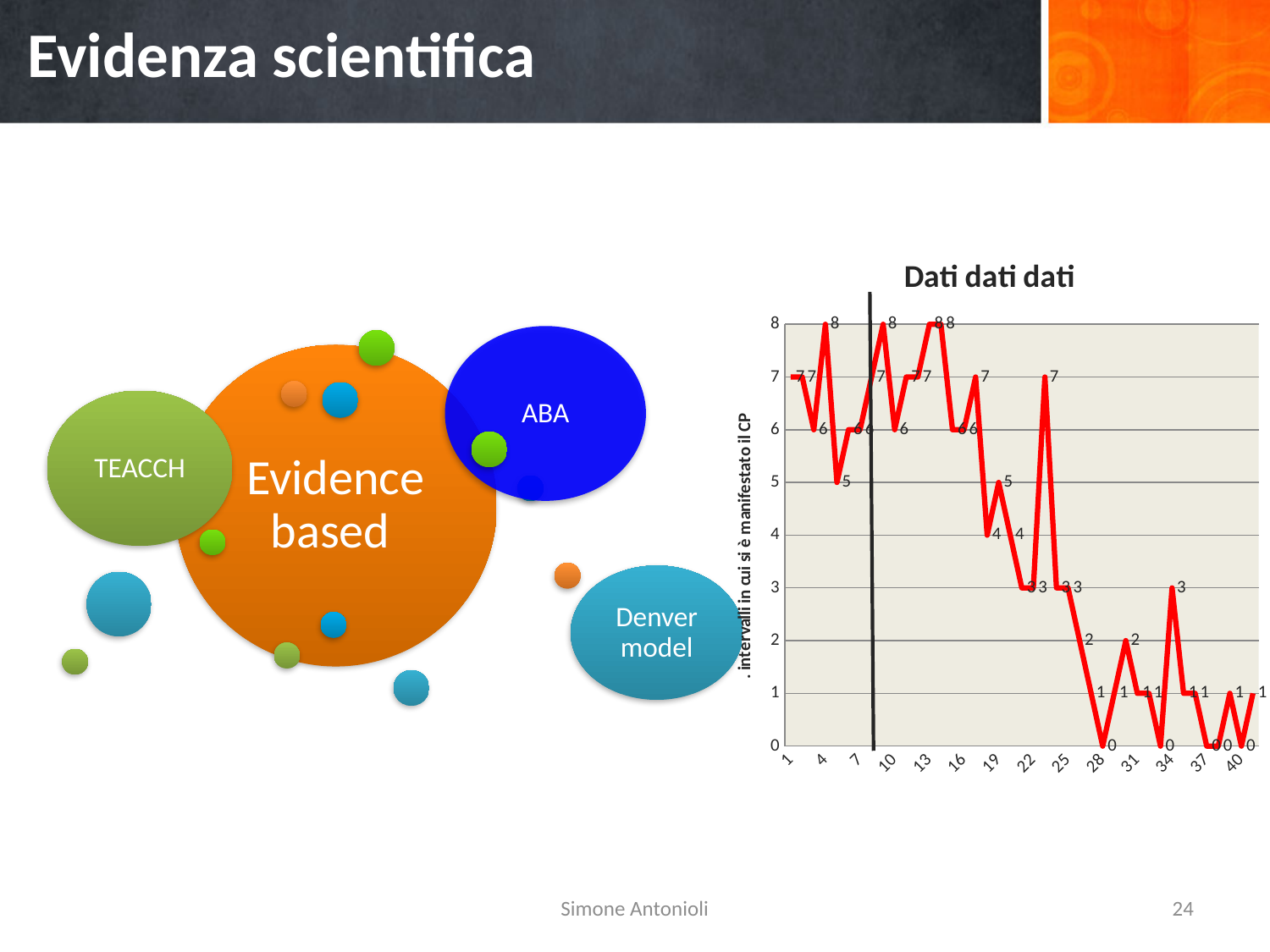
In the "Dati dati dati" chart, is the value at x = 10 greater or less than 4? greater How many data series are plotted in the "Dati dati dati" chart? 1 What is the highest value reached by the line in the "Dati dati dati" chart? 8 What is the title of the chart on the right of the slide? Dati dati dati What is the maximum value shown on the y axis of the "Dati dati dati" chart? 8 In the "Dati dati dati" chart, what is the value plotted at x = 1? 7 In the "Dati dati dati" chart, what is the value plotted at x = 4? 8 What is the lowest value reached by the line in the "Dati dati dati" chart? 0 What kind of chart is shown under the title "Dati dati dati"? line chart In the "Dati dati dati" chart, do the values generally rise or fall as you move from left to right along the x axis? fall In the "Dati dati dati" chart, is the value at x = 28 greater or less than 4? less In the "Dati dati dati" chart, which is larger: the value at x = 1 or the value at x = 40? the value at x = 1